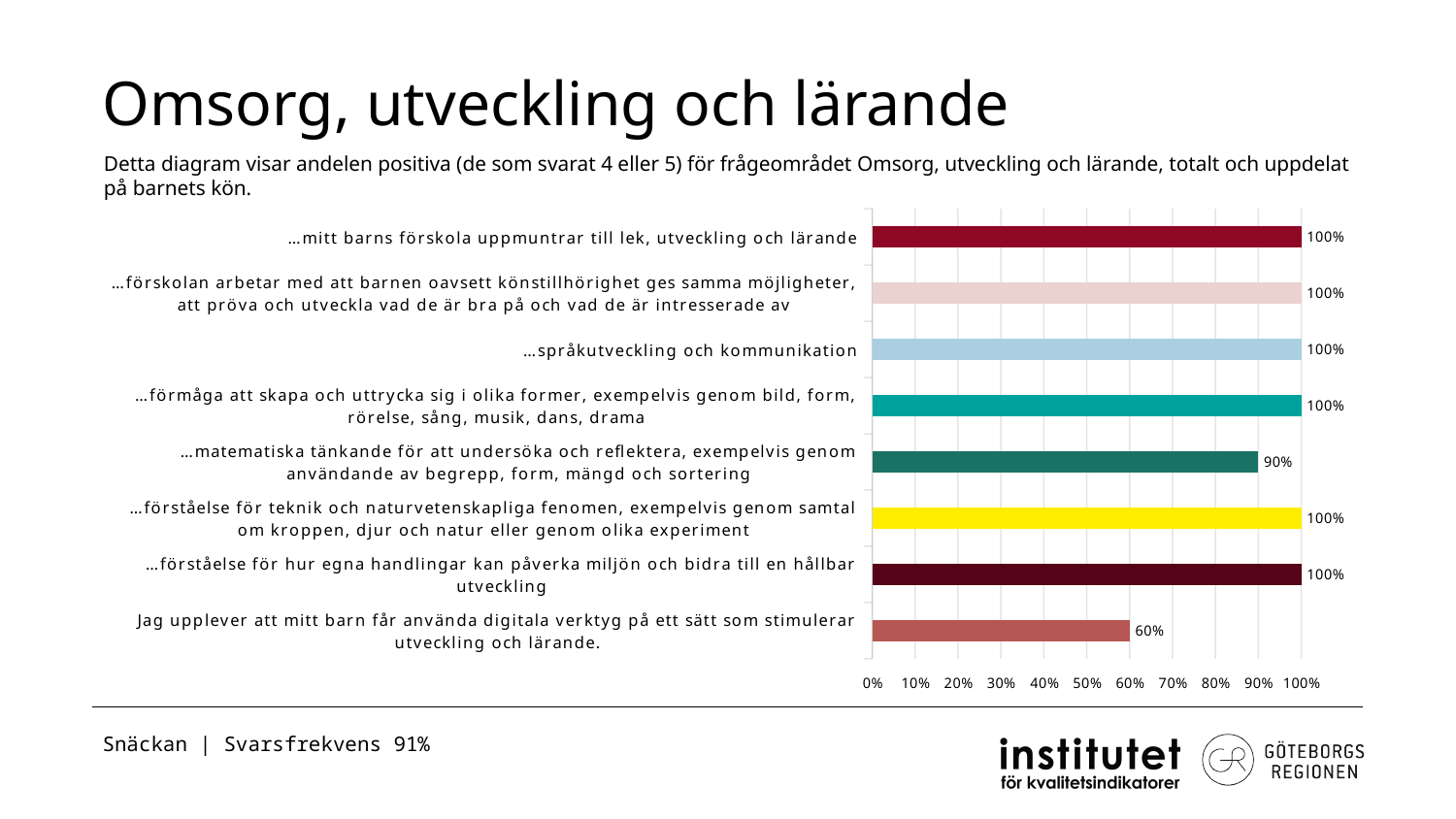
What is the value for "…språkutveckling och kommunikation"? 100% What is the value for "…förståelse för hur egna handlingar kan påverka miljön och bidra till en hållbar utveckling"? 100% What kind of chart is shown on the slide? Bar chart Which category has the lowest value? Jag upplever att mitt barn får använda digitala verktyg på ett sätt som stimulerar utveckling och lärande. What is the difference between the value for "…matematiska tänkande för att undersöka och reflektera…" and the value for "Jag upplever att mitt barn får använda digitala verktyg…"? 30% Which is larger: the value for "…förståelse för teknik och naturvetenskapliga fenomen…" or the value for "Jag upplever att mitt barn får använda digitala verktyg…"? …förståelse för teknik och naturvetenskapliga fenomen… How many categories are shown in the chart? 8 What is the value for "Jag upplever att mitt barn får använda digitala verktyg på ett sätt som stimulerar utveckling och lärande."? 60% What is the value for "…matematiska tänkande för att undersöka och reflektera, exempelvis genom användande av begrepp, form, mängd och sortering"? 90% What is the title of the slide containing the chart? Omsorg, utveckling och lärande What is the difference between the value for "…språkutveckling och kommunikation" and the value for "…matematiska tänkande för att undersöka och reflektera…"? 10% How many categories have a value of 100%? 6